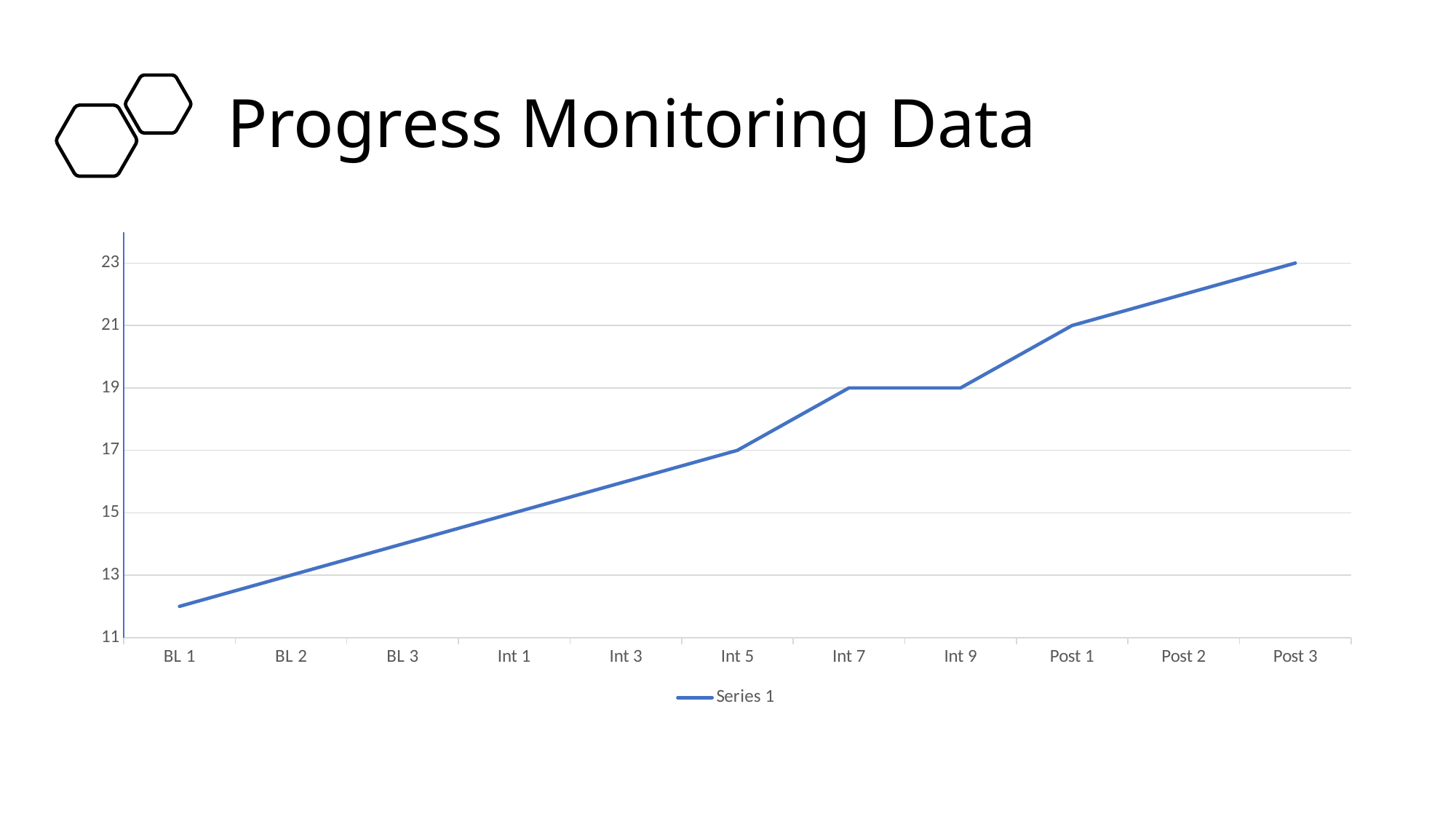
Which point has the highest value? Post 3 How many data points are plotted along the x axis? 11 What is the value at Post 3? 23 What type of chart is shown on the slide? line chart Is the value for BL 1 greater or less than 13? less How many series does the legend list? 1 What is the value at Post 1? 21 What is the value at Int 5? 17 Which point has the lowest value? BL 1 What is the difference between the values at Post 3 and Int 5? 6 What is the value at BL 2? 13 Do the values generally rise or fall from BL 1 to Post 3? rise